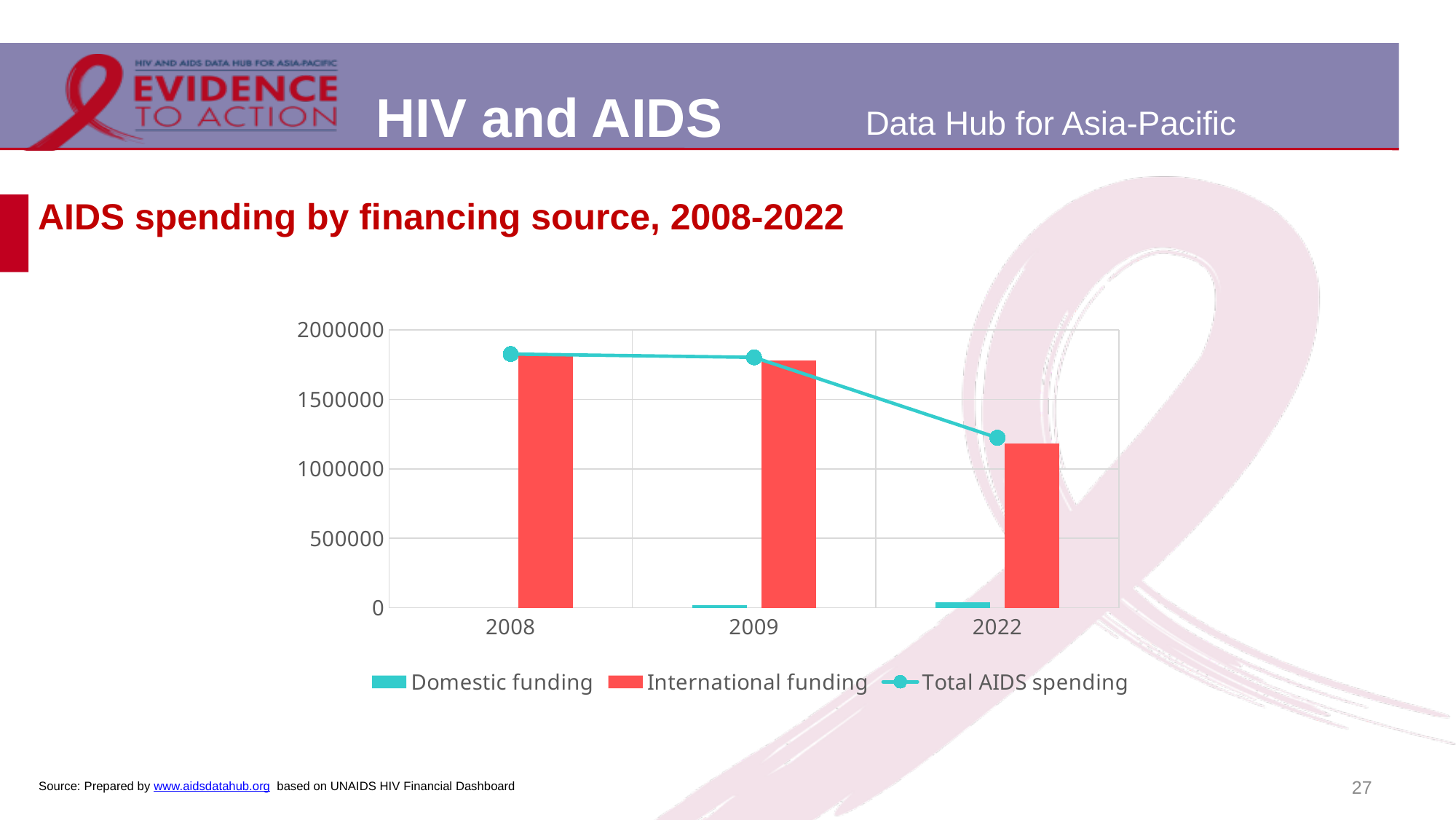
In 2022, which is larger: Domestic funding or International funding? International funding Is the value for International funding in 2008 greater or less than 1500000? greater What kind of chart is used to show Domestic funding and International funding? bar chart Does Total AIDS spending rise or fall from 2008 to 2022? fall What is the title of the chart? AIDS spending by financing source, 2008-2022 Which series is drawn as a line with markers? Total AIDS spending Which is larger: International funding in 2009 or International funding in 2022? 2009 In which year is International funding lowest? 2022 How many years are shown on the x axis of the chart? 3 How many series does the chart's legend list? 3 Is the value for Domestic funding in 2022 greater or less than 500000? less Is the value for International funding in 2022 greater or less than 1500000? less